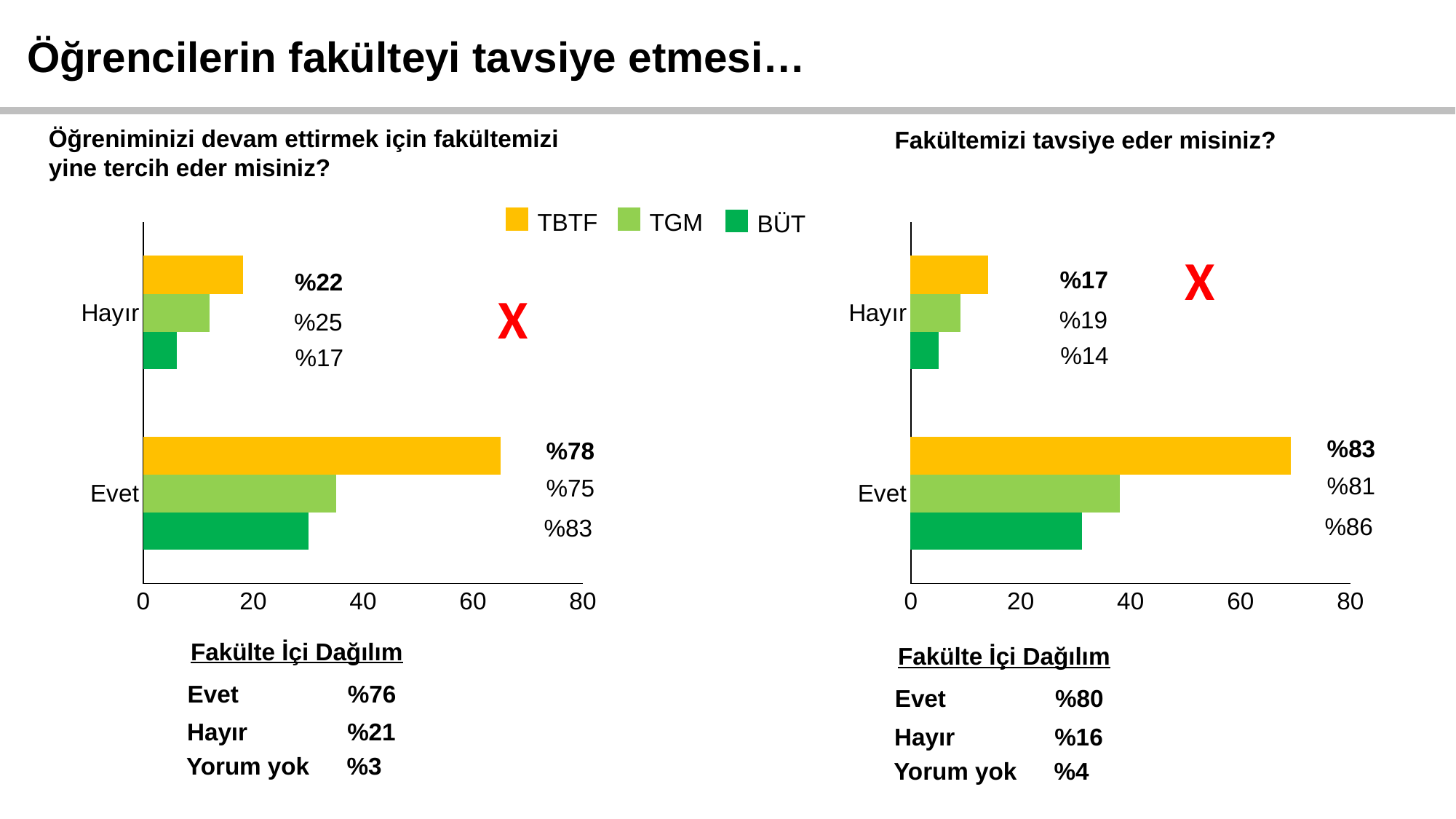
On the right chart (Fakültemizi tavsiye eder misiniz?), what is the TBTF value for Hayır? %17 How many categories are shown on the right chart (Fakültemizi tavsiye eder misiniz?)? 2 On the left chart (Öğreniminizi devam ettirmek için fakültemizi yine tercih eder misiniz?), is the TBTF bar for Evet greater or less than 60 on the axis? greater On the right chart (Fakültemizi tavsiye eder misiniz?), which is larger for Hayır: the TGM value or the BÜT value? TGM How many series does the legend list? 3 On the left chart (Öğreniminizi devam ettirmek için fakültemizi yine tercih eder misiniz?), which series has the lowest value for Hayır? BÜT On the right chart (Fakültemizi tavsiye eder misiniz?), what is the BÜT value for Evet? %86 On the left chart (Öğreniminizi devam ettirmek için fakültemizi yine tercih eder misiniz?), what is the TGM value for Hayır? %25 On the left chart (Öğreniminizi devam ettirmek için fakültemizi yine tercih eder misiniz?), what is the TBTF value for Evet? %78 What kind of chart is the left chart (Öğreniminizi devam ettirmek için fakültemizi yine tercih eder misiniz?)? Bar chart